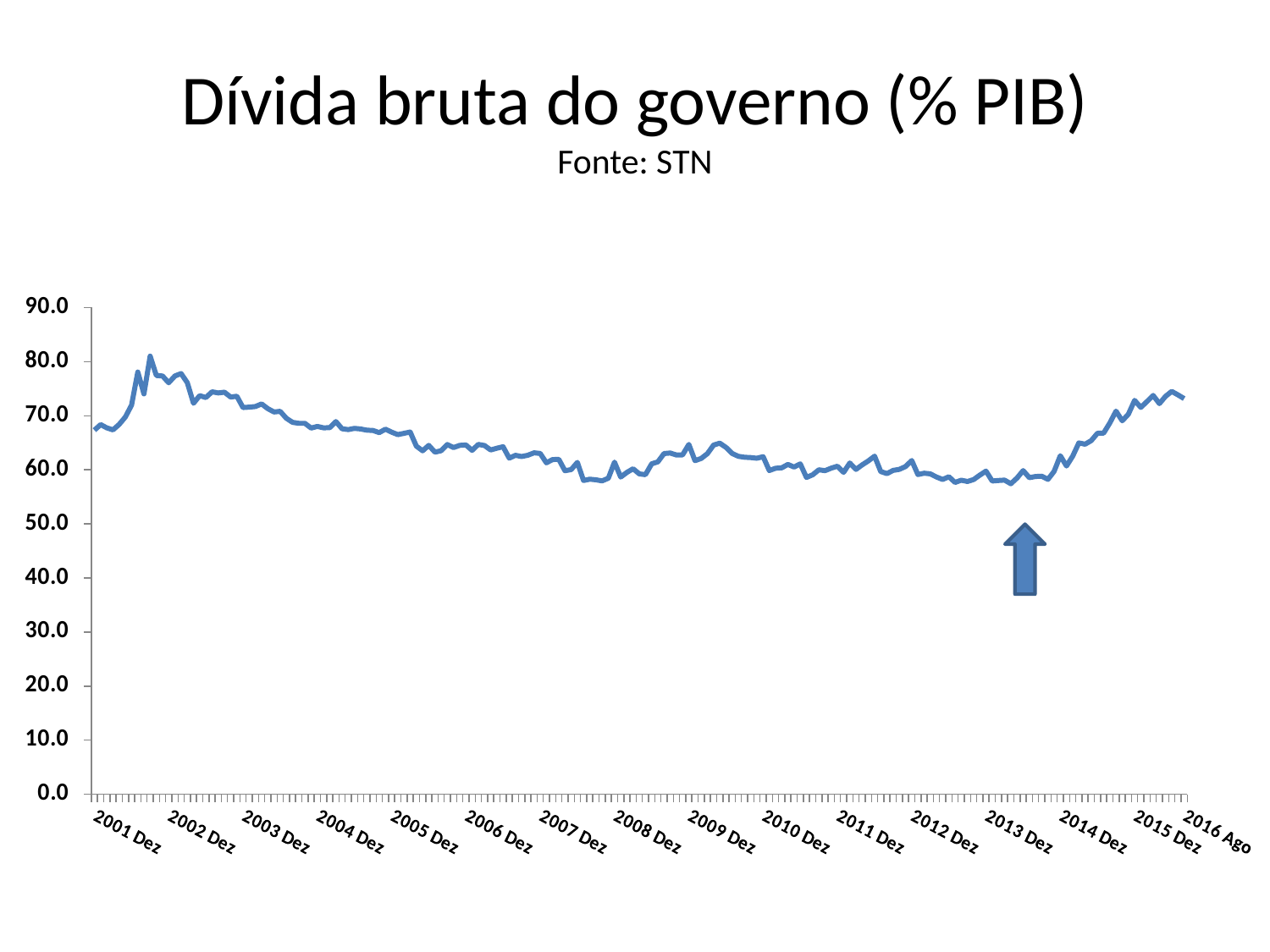
Does the line generally rise or fall between 2002 Dez and 2013 Dez? fall What is the highest value shown on the vertical axis? 90.0 Is the value for 2005 Dez greater or less than 60.0? greater What is the title of the chart? Dívida bruta do governo (% PIB) Does the line rise or fall between 2013 Dez and 2016 Ago? rise What kind of chart is shown on the slide? line chart What source is cited for the chart data? STN Is the value for 2002 Dez greater or less than 70.0? greater Which is higher, the value at 2002 Dez or the value at 2013 Dez? 2002 Dez Is the value for 2001 Dez greater or less than 70.0? less